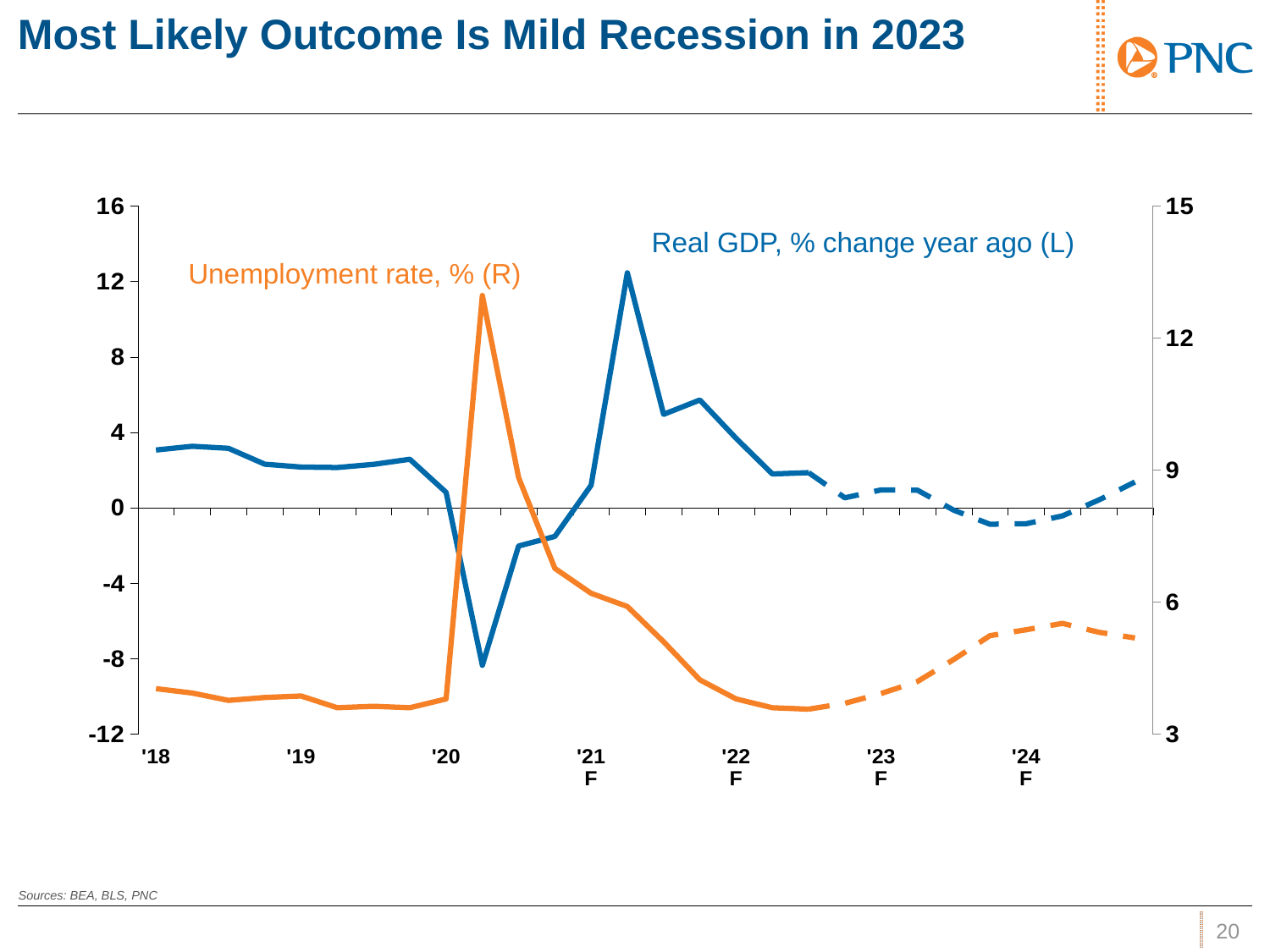
Is the value of Real GDP, % change year ago at the start of '18 greater or less than 0? greater Does Real GDP, % change year ago rise or fall from its 2021 peak to the end of '22? fall Is the Unemployment rate at the start of '18 greater or less than 6 on the right axis? less What is the title of the slide containing the chart? Most Likely Outcome Is Mild Recession in 2023 Is the lowest value of Real GDP, % change year ago in 2020 greater or less than -4 on the left axis? less How many data series are plotted on the chart? 2 How many year labels are shown on the x axis? 7 What kind of chart is shown on the slide? line chart Does the forecast Unemployment rate rise or fall from the start of '23 to the start of '24? rise Which axis, left or right, is the Unemployment rate series plotted against? right